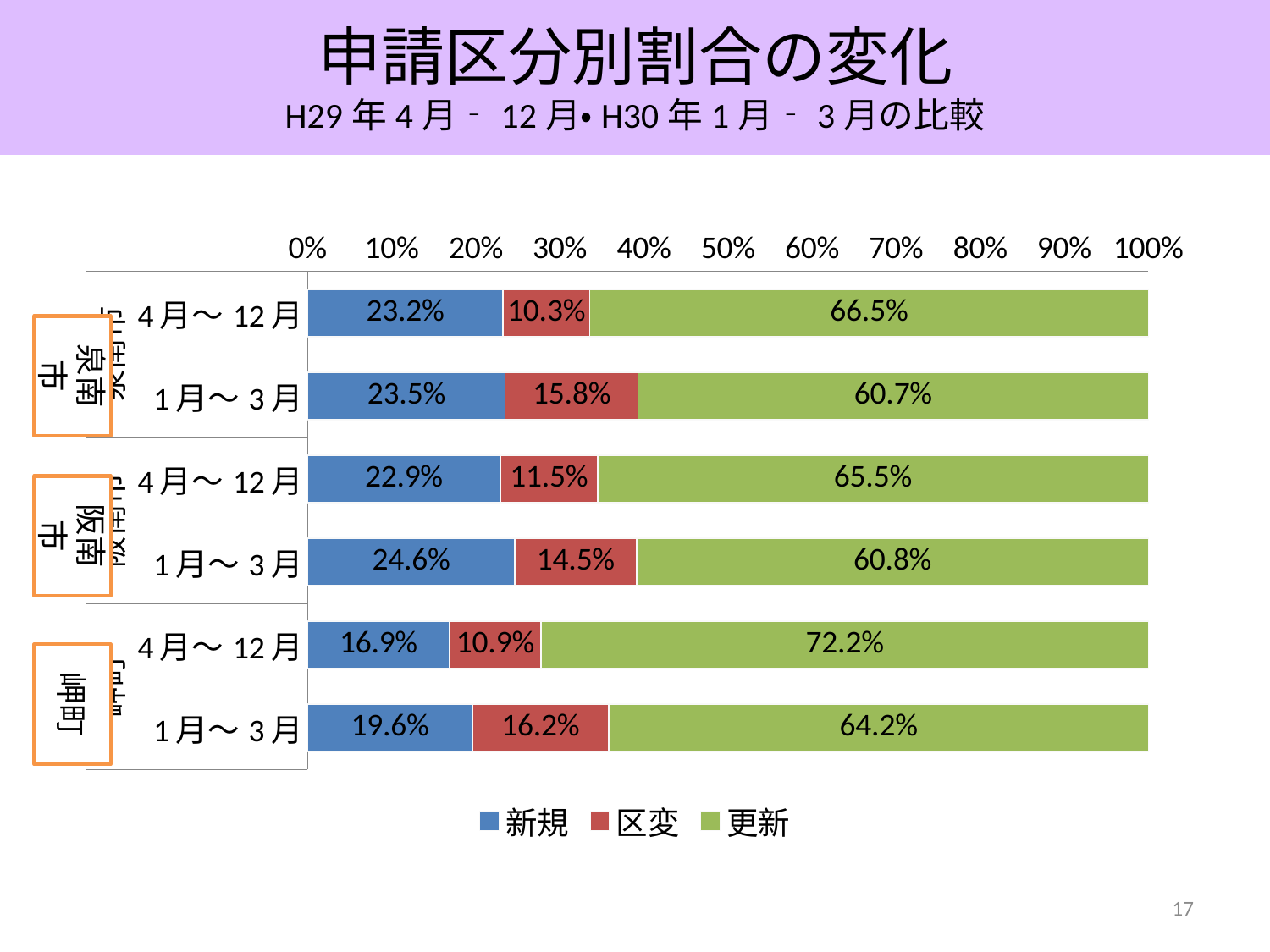
Which bar has the lowest 新規 value? bottom group, 4月～12月 (16.9%) How many series does the legend list? 3 How many bars are plotted in the chart? 6 Which bar has the highest 更新 value? bottom group, 4月～12月 (72.2%) What is the total of the stacked bar for 阪南市 in 4月～12月? 99.9% What is the difference between the 区変 values for 泉南市 in 1月～3月 and 4月～12月? 5.5% Which is larger, the 新規 value for 阪南市 in 1月～3月 or for 泉南市 in 1月～3月? 阪南市 1月～3月 (24.6%) What is the 更新 value for 泉南市 in 4月～12月? 66.5% Which series is shown in green in the legend? 更新 What is the 新規 value for the bottom group in 4月～12月? 16.9% What is the 区変 value for 阪南市 in 1月～3月? 14.5% What kind of chart is shown on the slide? stacked bar chart